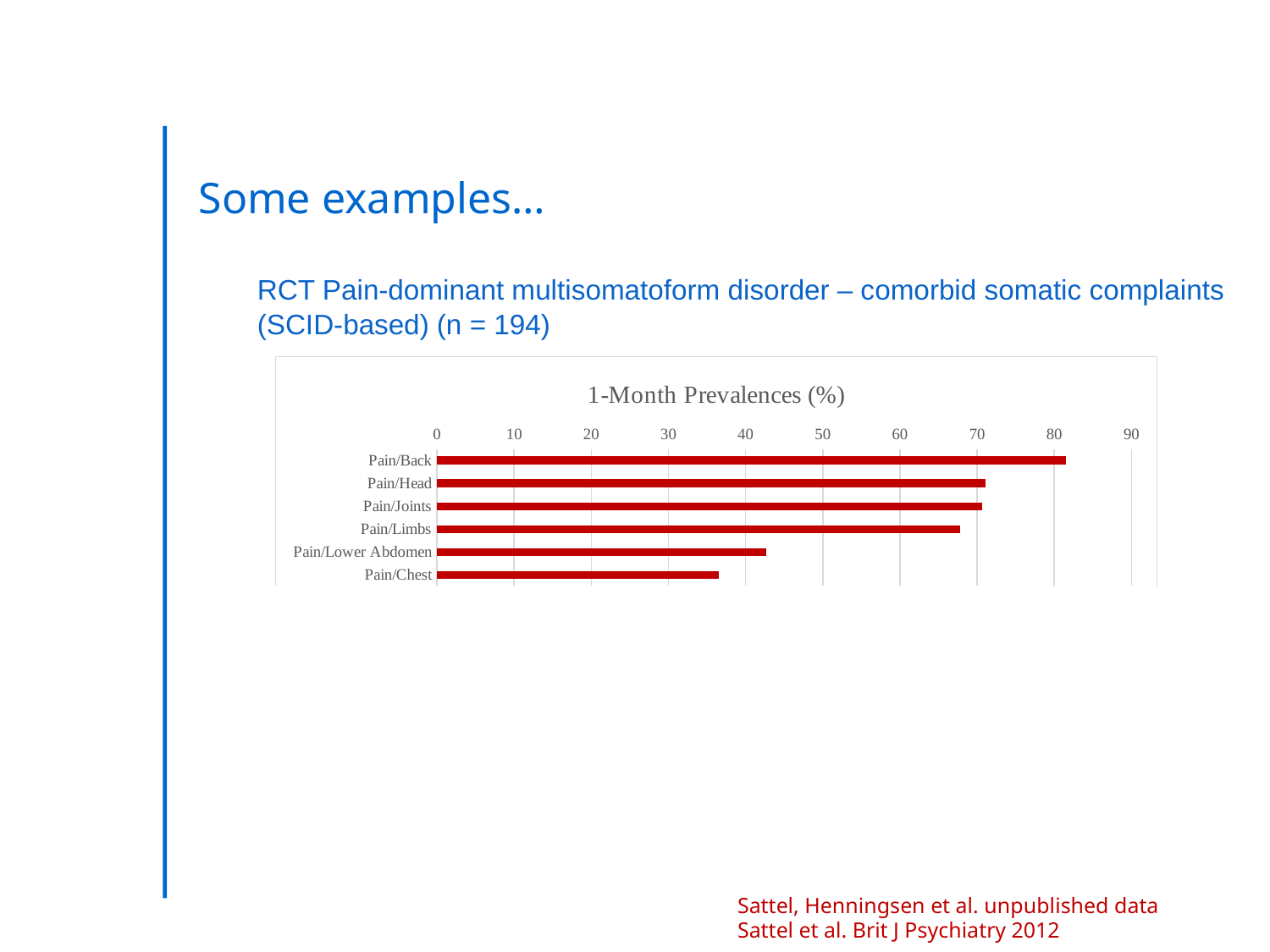
What is the title of the chart? 1-Month Prevalences (%) How many categories are plotted in the chart? 6 Is the value for Pain/Chest greater or less than 40? less Which category has the lowest 1-month prevalence? Pain/Chest Is the value for Pain/Back greater or less than 80? greater Is the value for Pain/Lower Abdomen greater or less than 40? greater Which category has the highest 1-month prevalence? Pain/Back Which is larger, the value for Pain/Limbs or the value for Pain/Lower Abdomen? Pain/Limbs What kind of chart is shown on the slide? bar chart What is the highest tick value shown on the horizontal axis? 90